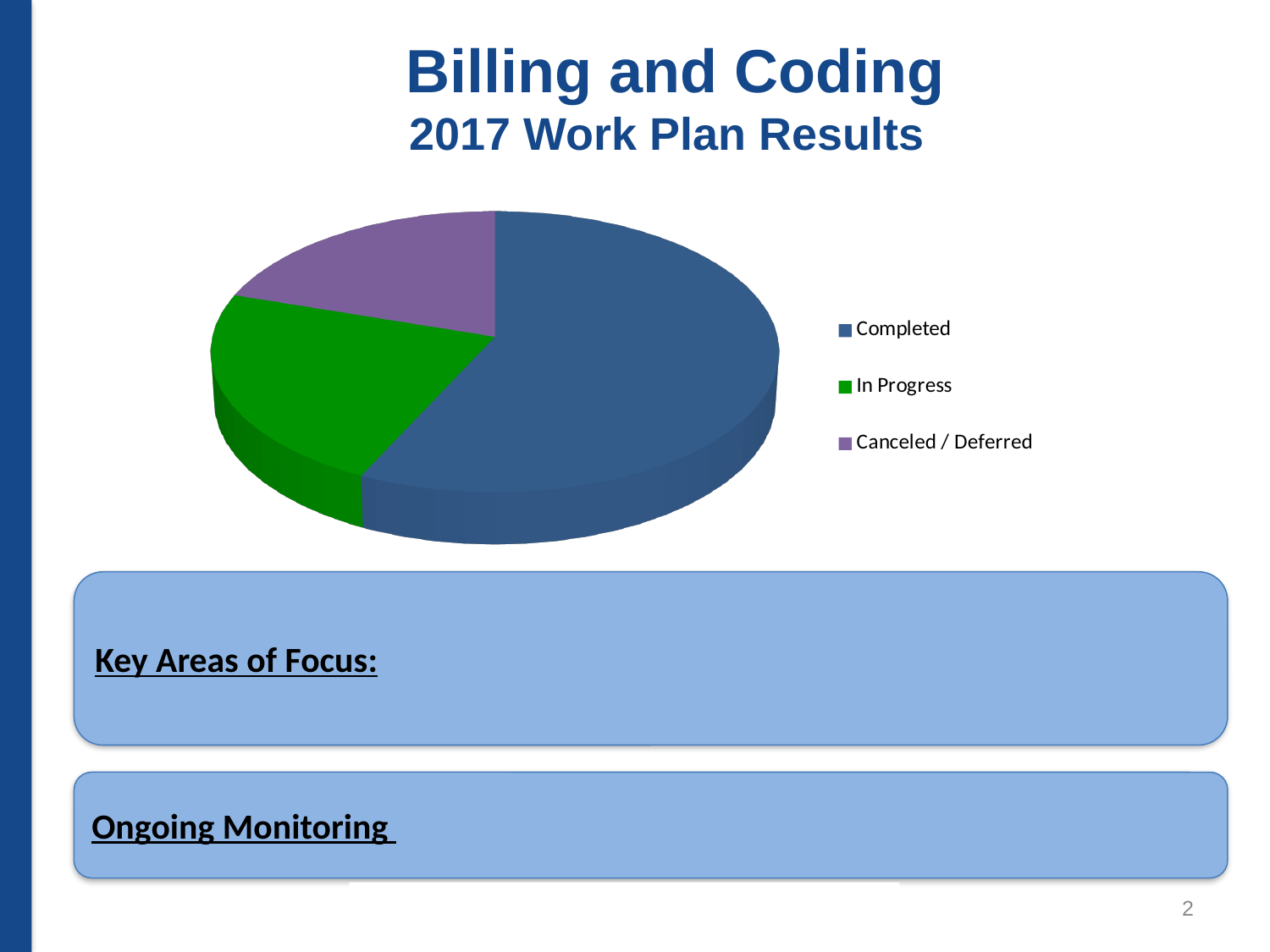
How many entries does the legend of the pie chart list? 3 Which slice is larger, Completed or In Progress? Completed What colour is the Completed slice in the pie chart? Blue Which slice is larger, Completed or Canceled / Deferred? Completed How many slices does the pie chart have? 3 Which category has the largest slice of the pie chart? Completed Which category is shown in green in the pie chart? In Progress What kind of chart is shown on the slide? Pie chart